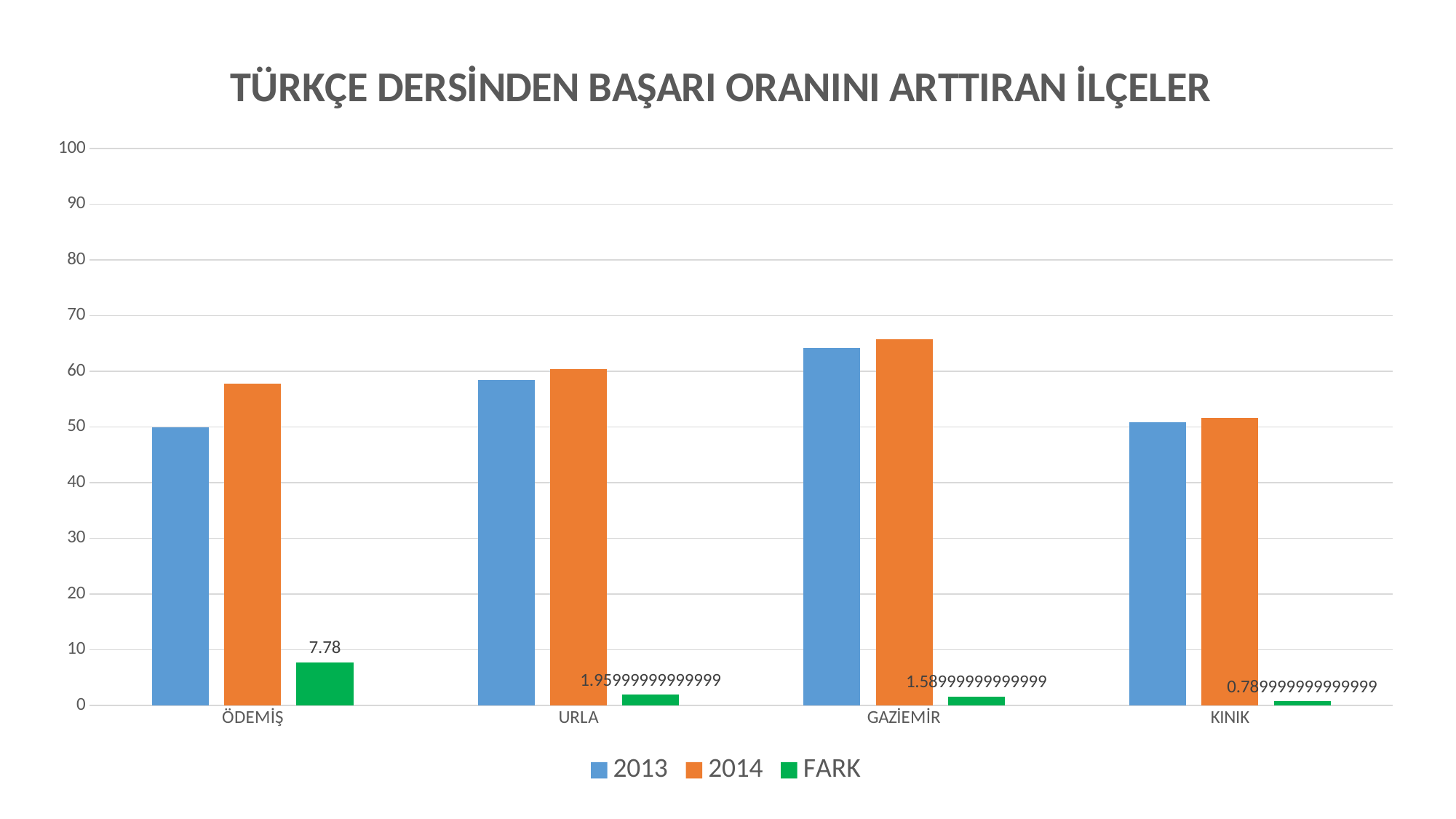
How many series does the legend list? 3 What kind of chart is shown on the slide? Bar chart What is the FARK value for KINIK? 0.789999999999999 Is the 2014 value for GAZİEMİR greater or less than 70? less What is the FARK value for GAZİEMİR? 1.58999999999999 Is the 2013 value for GAZİEMİR greater or less than 60? greater What is the FARK value for URLA? 1.95999999999999 Is the 2014 value for ÖDEMİŞ greater or less than 60? less Which district has the lowest FARK value? KINIK Which district has the highest 2014 value? GAZİEMİR What is the FARK value for ÖDEMİŞ? 7.78 Which district has the highest FARK value? ÖDEMİŞ